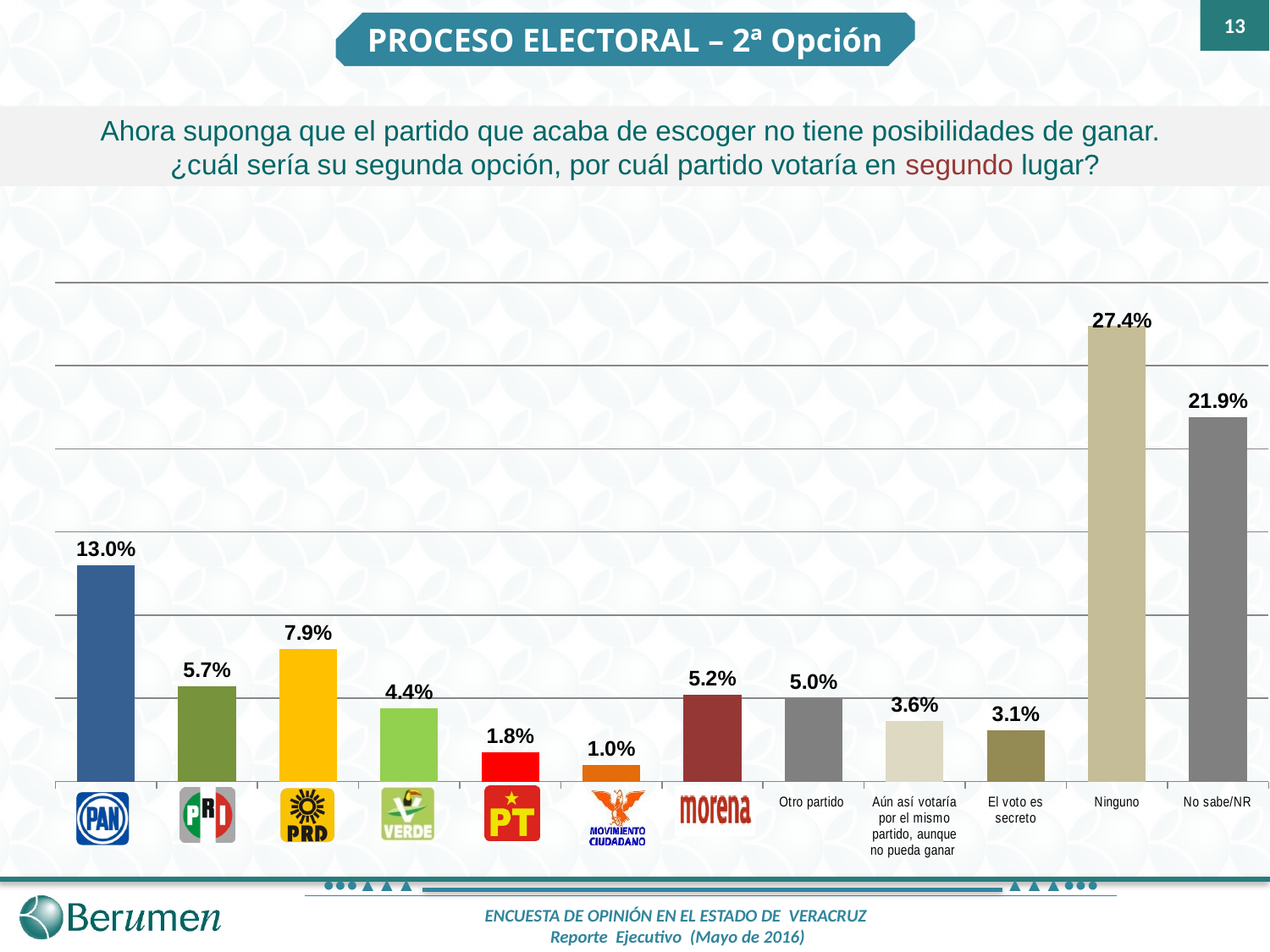
What percentage is shown for PAN? 13.0% What value is shown for the 'Ninguno' bar? 27.4% What is the difference between the values for Ninguno and No sabe/NR? 5.5% Which has a larger value, PRD or PRI? PRD Which category has the highest value? Ninguno What percentage is shown for Movimiento Ciudadano? 1.0% Which has a larger value, Morena or Otro partido? Morena What is the difference between the values for PAN and PRD? 5.1% What kind of chart is shown on the slide? Bar chart What value is shown for 'No sabe/NR'? 21.9% Which category has the lowest value? Movimiento Ciudadano How many bars are shown in the chart? 12